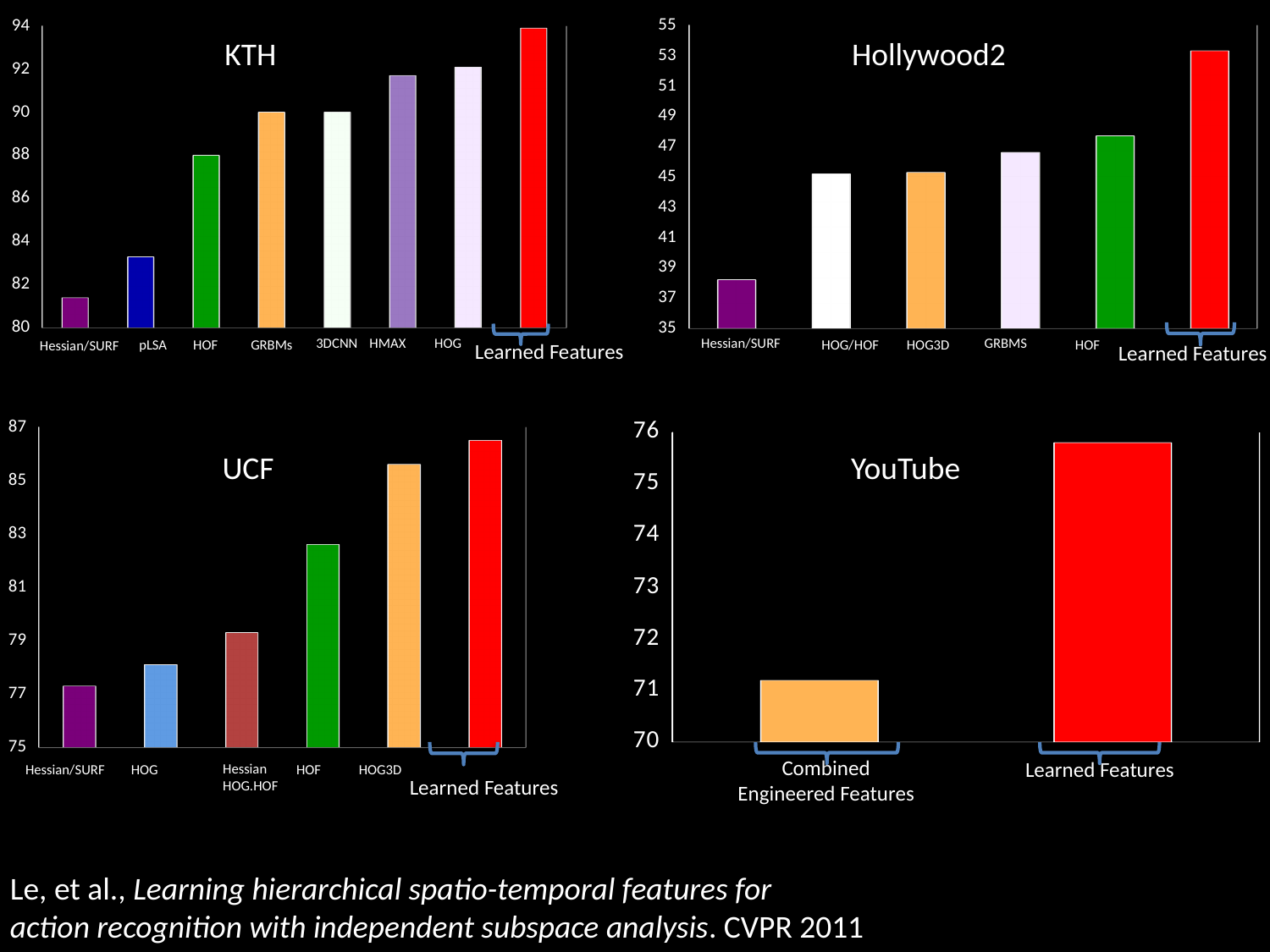
How many bars are plotted in the KTH chart? 8 In the YouTube chart, is the value for Combined Engineered Features greater or less than 72? less In the KTH chart, which category has the lowest value? Hessian/SURF In the UCF chart, which category has the lowest value? Hessian/SURF In the KTH chart, is the value for pLSA greater or less than 84? less How many bars are plotted in the YouTube chart? 2 In the KTH chart, which category has the highest value? Learned Features In the UCF chart, which is larger, the value for HOF or the value for Hessian HOG.HOF? HOF In the Hollywood2 chart, which category has the highest value? Learned Features How many bars are plotted in the Hollywood2 chart? 6 What kind of chart is the YouTube chart? bar chart In the Hollywood2 chart, is the value for Hessian/SURF greater or less than 39? less